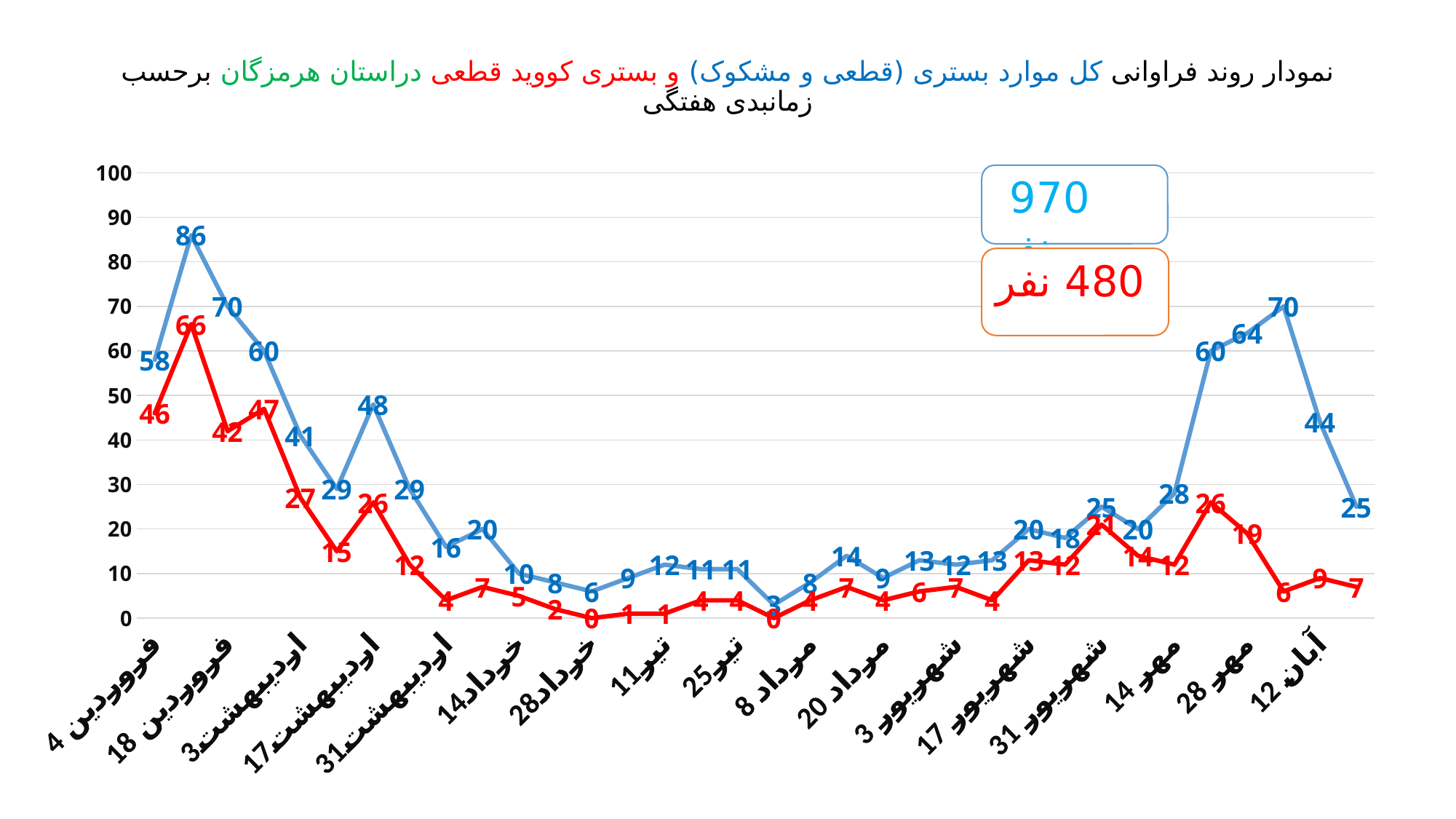
What is the difference between the peak of the blue line (86) and the peak of the red line (66)? 20 What is written in the orange-bordered box at the top right of the chart? 480 نفر What is the value of the blue line at the first point (فروردین 4)? 58 What kind of chart is shown on the slide? line chart What is the value of the red line at the first point (فروردین 4)? 46 What is the lowest value on the blue line? 3 At the last point on the chart, which line has the larger value, blue or red? blue What is the highest value on the red line? 66 What is the lowest value on the red line? 0 What number is shown in the blue box at the top right of the chart? 970 What is the highest value on the blue line? 86 How many data series are plotted on the chart? 2